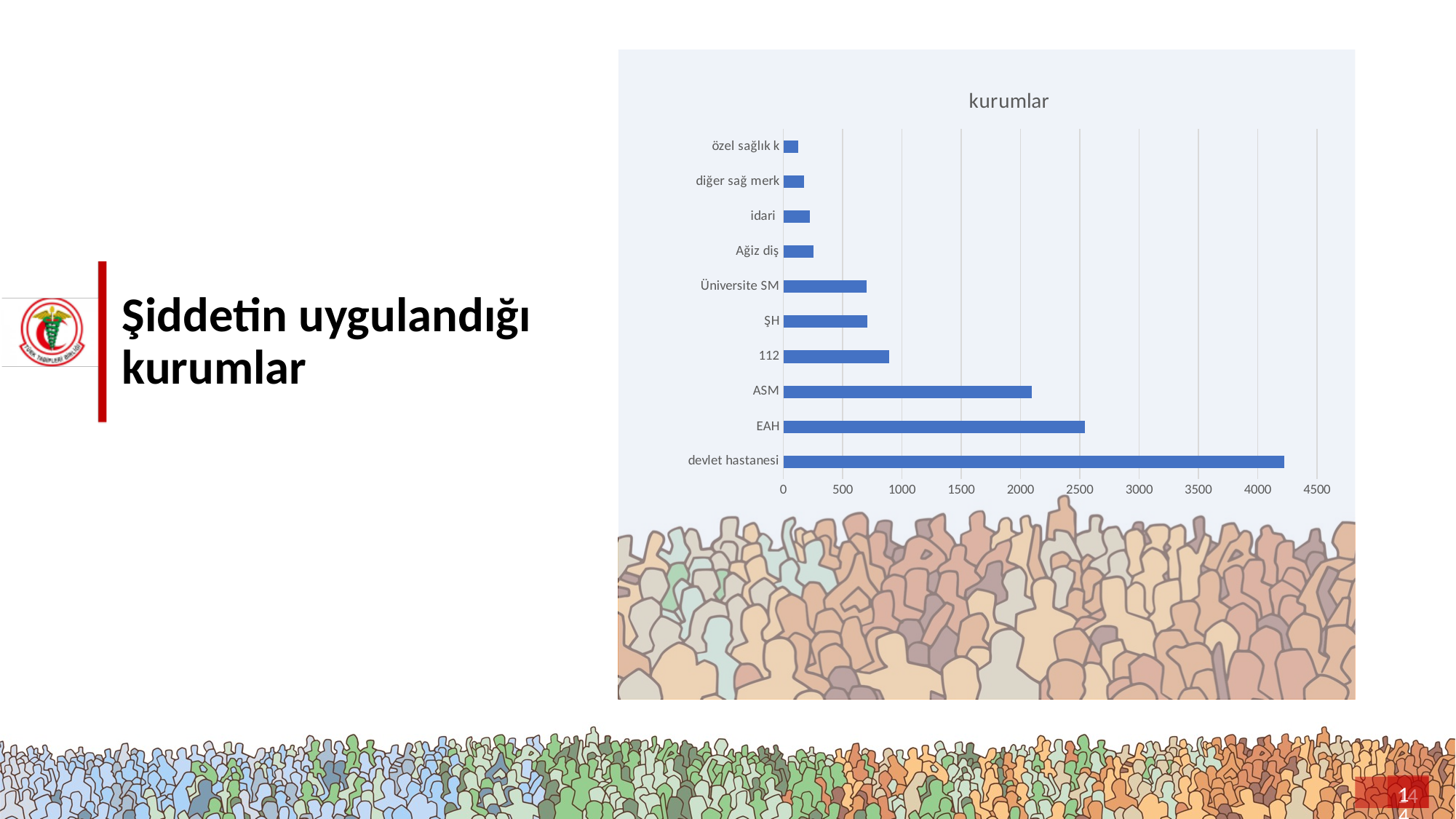
Is the value for ASM greater or less than 2000? greater Is the value for EAH greater or less than 3000? less How many categories are plotted in the chart? 10 Which category has the highest value in the chart? devlet hastanesi Which has a larger value, EAH or ASM? EAH What kind of chart is shown on the slide? bar chart Which has a larger value, 112 or ŞH? 112 What is the title of the chart? kurumlar Which category has the lowest value in the chart? özel sağlık k Is the value for Ağiz diş greater or less than 500? less